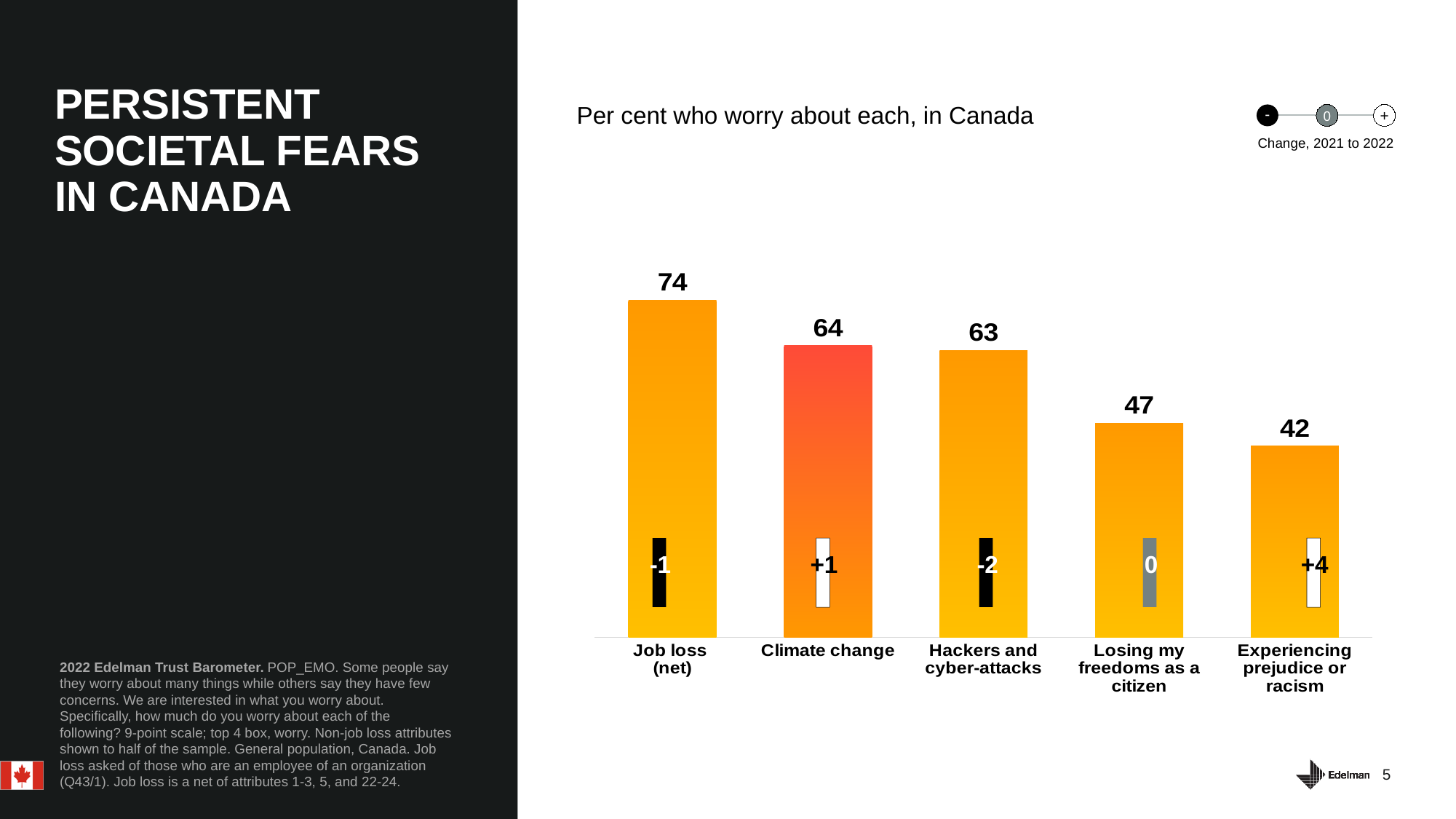
Which fear has the highest per cent of people worried about it? Job loss (net) What per cent of people in Canada worry about climate change? 64 What is the change from 2021 to 2022 shown for experiencing prejudice or racism? +4 What per cent of people in Canada worry about experiencing prejudice or racism? 42 What is the change from 2021 to 2022 shown for hackers and cyber-attacks? -2 What is the difference between the per cent worried about job loss (net) and the per cent worried about losing my freedoms as a citizen? 27 Which is larger: the per cent worried about climate change or the per cent worried about losing my freedoms as a citizen? Climate change What per cent of people in Canada worry about hackers and cyber-attacks? 63 Which fear has the lowest per cent of people worried about it? Experiencing prejudice or racism What per cent of people in Canada worry about job loss (net)? 74 How many fears are shown in the chart? 5 What kind of chart is shown on the slide? Bar chart